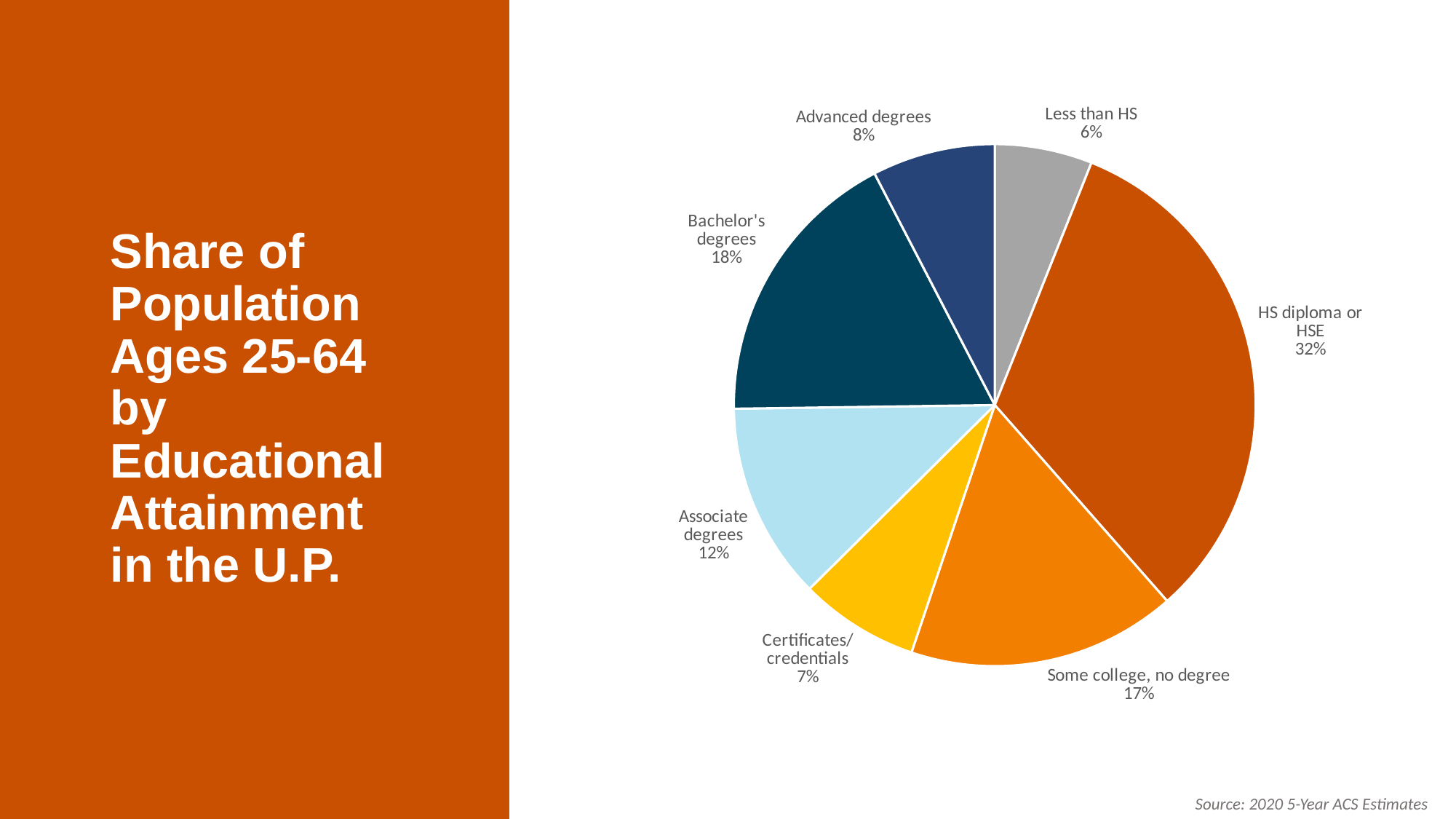
Which category has the smallest share of the pie? Less than HS What is the combined share of Bachelor's degrees and Advanced degrees? 26% What is the difference in percentage points between Bachelor's degrees and Associate degrees? 6 What kind of chart is shown on the slide? Pie chart What is the source cited for the chart data? 2020 5-Year ACS Estimates What share of the population has a HS diploma or HSE? 32% How many categories are shown in the pie chart? 7 What share of the population has Certificates/credentials? 7% Which category has the largest share of the pie? HS diploma or HSE Which is larger, the share for Some college, no degree or the share for Associate degrees? Some college, no degree What share of the population has Bachelor's degrees? 18% What share of the population has Less than HS? 6%